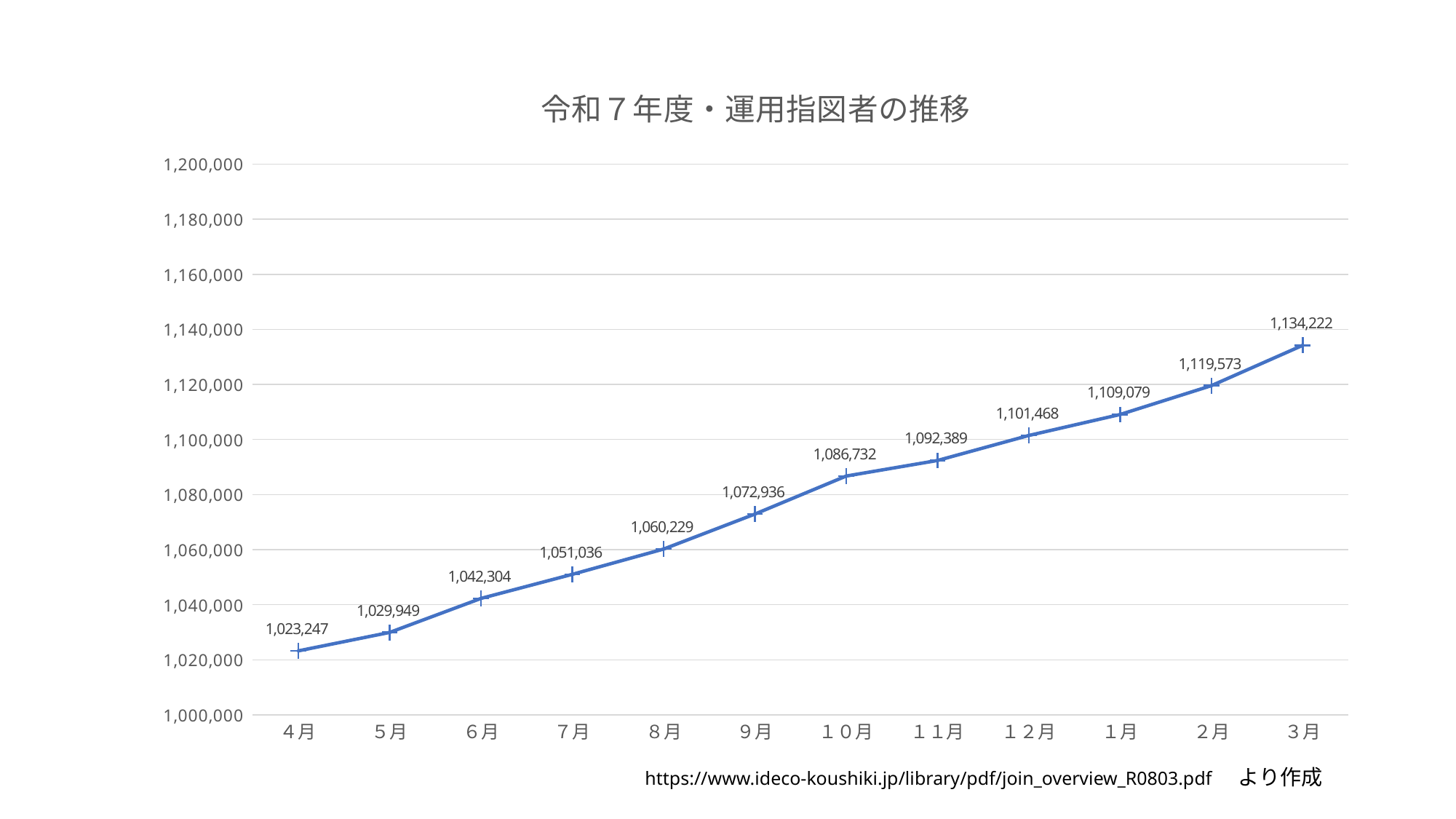
Which is larger, the value for 7月 or the value for 11月? 11月 What is the value for 4月? 1,023,247 What is the value for 10月? 1,086,732 What kind of chart is shown on the slide? Line chart Do the values rise or fall from 4月 to 3月? Rise How many months are plotted on the chart? 12 What is the difference between the values for 3月 and 4月? 110,975 Which month has the highest value? 3月 Which month has the lowest value? 4月 What is the value for 3月? 1,134,222 What is the difference between the values for 10月 and 9月? 13,796 What is the value for 12月? 1,101,468